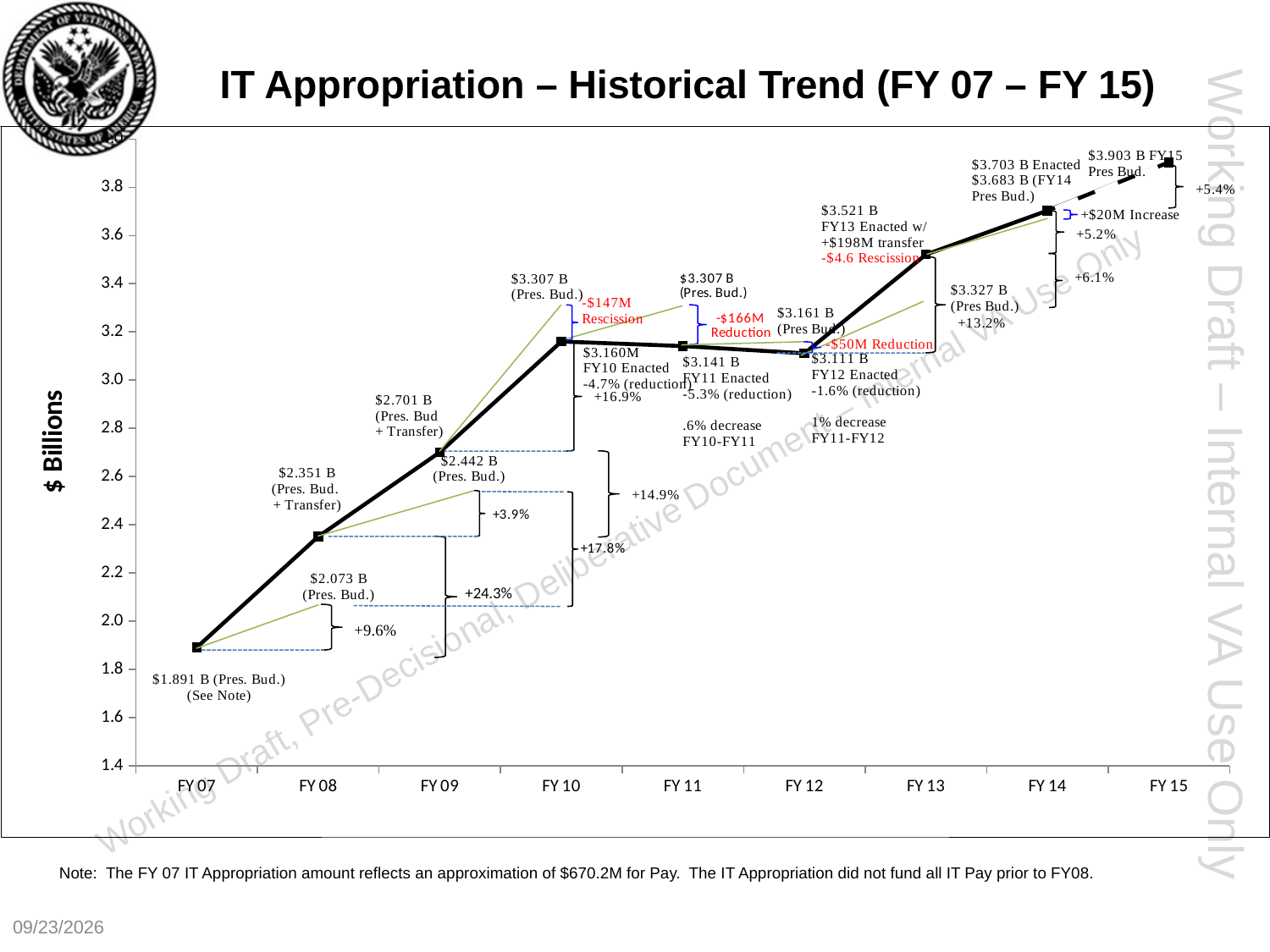
What is the title of the chart? IT Appropriation – Historical Trend (FY 07 – FY 15) What is the label on the vertical axis of the chart? $ Billions Is the FY12 Enacted value greater or less than 3.2 on the vertical axis? less What is the FY 07 IT Appropriation value (Pres. Bud.) shown on the chart? $1.891 B Which fiscal year has the highest value on the chart? FY 15 Which is larger, the FY11 Enacted value or the FY12 Enacted value? FY11 Enacted ($3.141 B) What kind of chart is shown on the slide? Line chart Which fiscal year has the lowest value on the chart? FY 07 What percentage change is shown between FY 07 and FY 08 on the chart? +24.3% What is the FY13 Enacted value shown on the chart? $3.521 B What is the FY15 Pres. Bud. value shown on the chart? $3.903 B How many fiscal years are shown along the x axis of the chart? 9